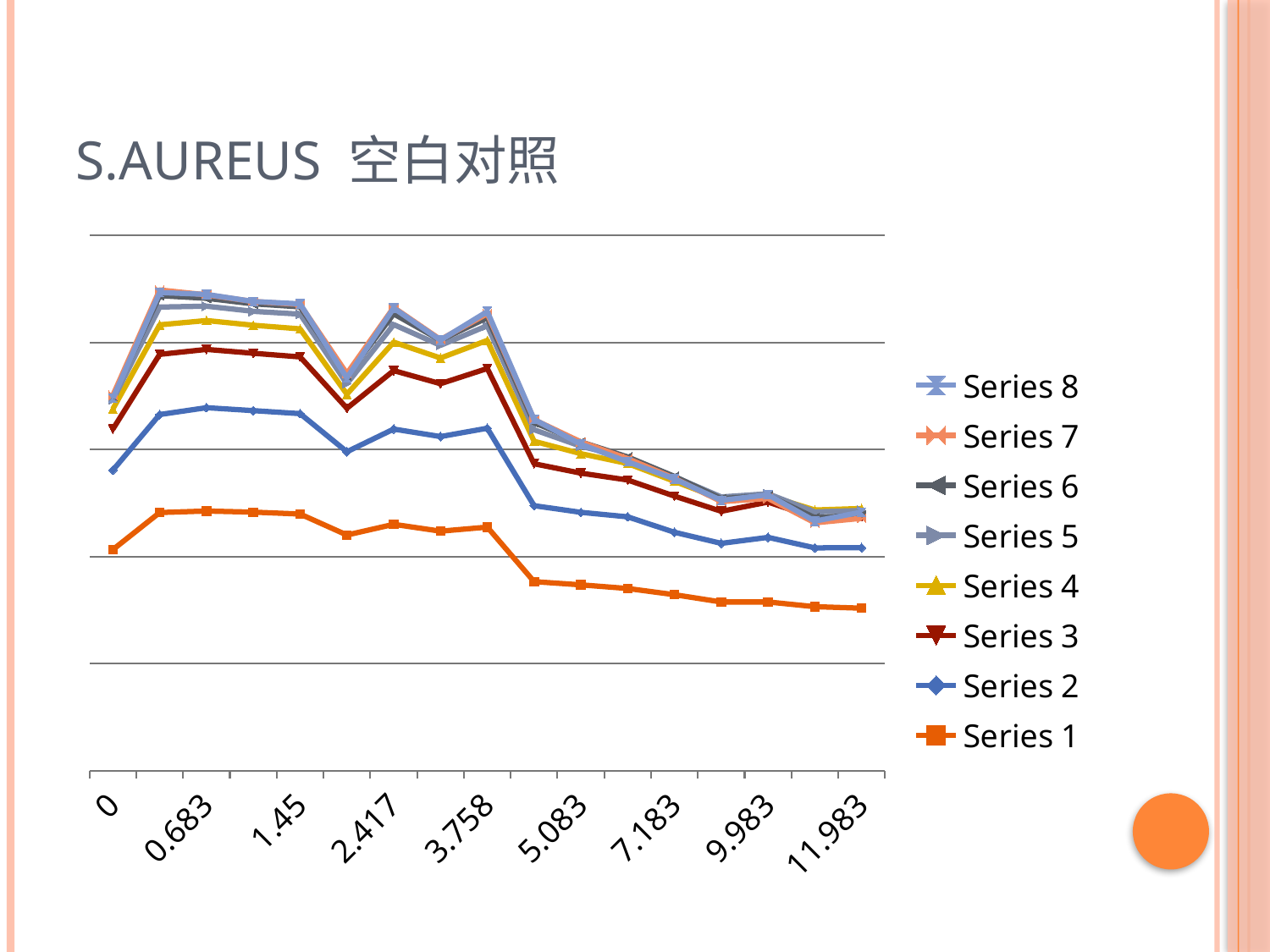
How many data points does each line have along the x axis? 17 How many series does the legend list? 8 What kind of chart is shown on the slide? line chart For Series 1, is the value at x = 0 higher or lower than the value at x = 11.983? higher What is the last label shown on the x axis? 11.983 Do the values of Series 2 rise or fall from x = 0 to x = 0.683? rise What is the title of the slide above the chart? S.AUREUS 空白对照 Do the values of Series 1 rise or fall from x = 3.758 to x = 11.983? fall